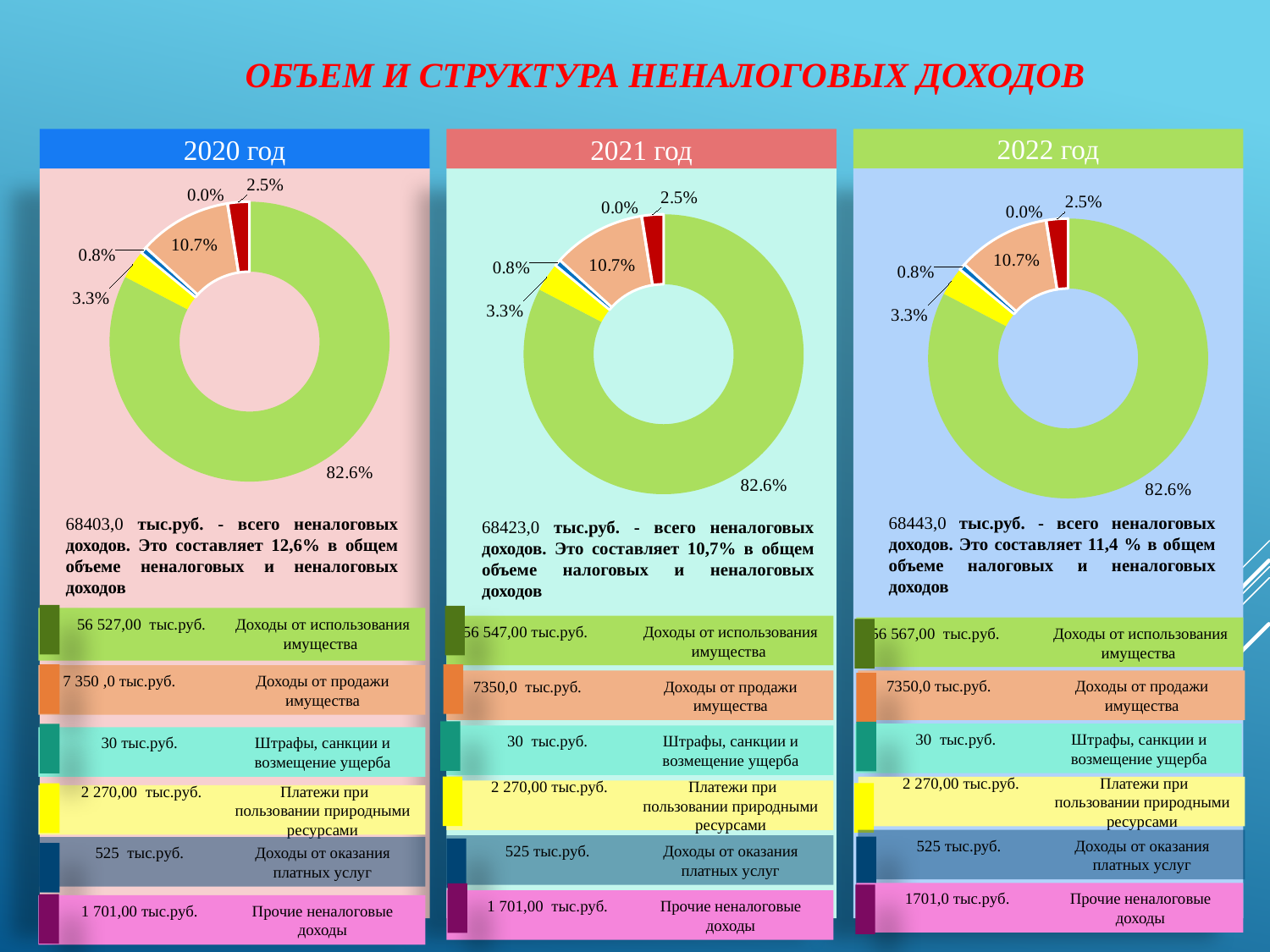
In the 2022 год chart, which is larger: the yellow slice at 3.3% or the red slice at 2.5%? the yellow slice (3.3%) In the 2021 год chart, what share does the orange slice (Доходы от продажи имущества) have? 10.7% In the 2022 год chart, what share does the yellow slice (Платежи при пользовании природными ресурсами) have? 3.3% How many donut charts are shown on the slide? 3 How many percentage labels (slices) are shown on the 2022 год chart? 6 In the 2021 год chart, what is the smallest share shown? 0.0% In the 2020 год chart, what is the difference between the largest slice (82.6%) and the 10.7% slice? 71.9 percentage points In the 2020 год chart, what is the largest share shown? 82.6% According to the text under the 2021 год chart, what is the total of non-tax revenues? 68423,0 тыс.руб. What kind of chart is used for the 2020 год panel? donut (pie) chart In the 2022 год legend, what value is given for Доходы от использования имущества? 56 567,00 тыс.руб. In the 2021 год legend, what value is given for Доходы от продажи имущества? 7350,0 тыс.руб.